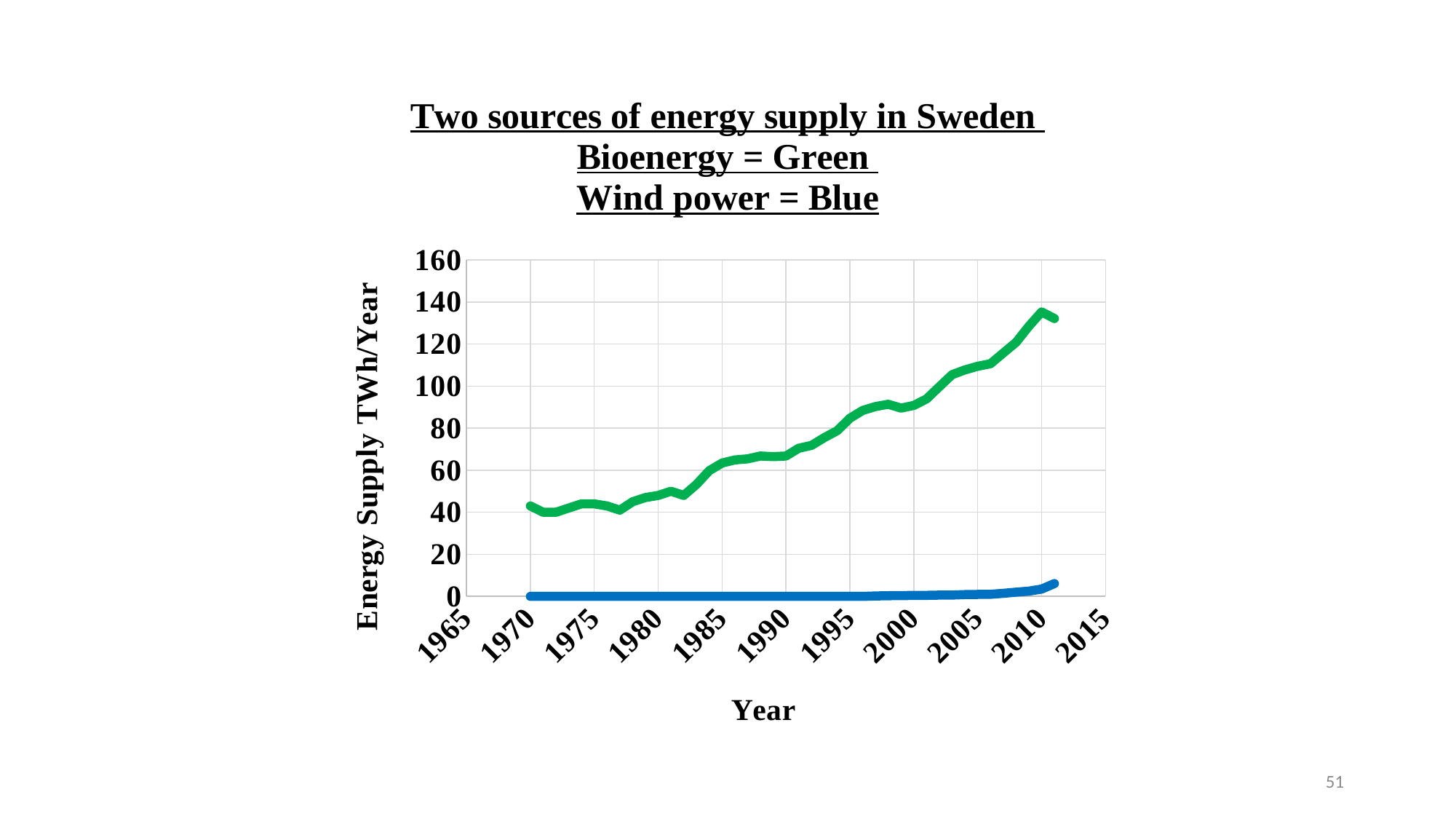
Which of the two series reaches the highest value on the chart? Bioenergy Is the bioenergy value in 2000 greater or less than 80? greater Is the bioenergy value in 1990 greater or less than 60? greater Does the bioenergy (green) line generally rise or fall from 1970 to 2010? rise Is the bioenergy value around 2010 greater or less than 120? greater Which energy source has the higher supply in 2010, bioenergy or wind power? Bioenergy Which colour represents wind power on the chart? Blue How many data series are plotted on the chart? 2 What kind of chart is shown on the slide? line chart What is the label of the vertical axis? Energy Supply TWh/Year